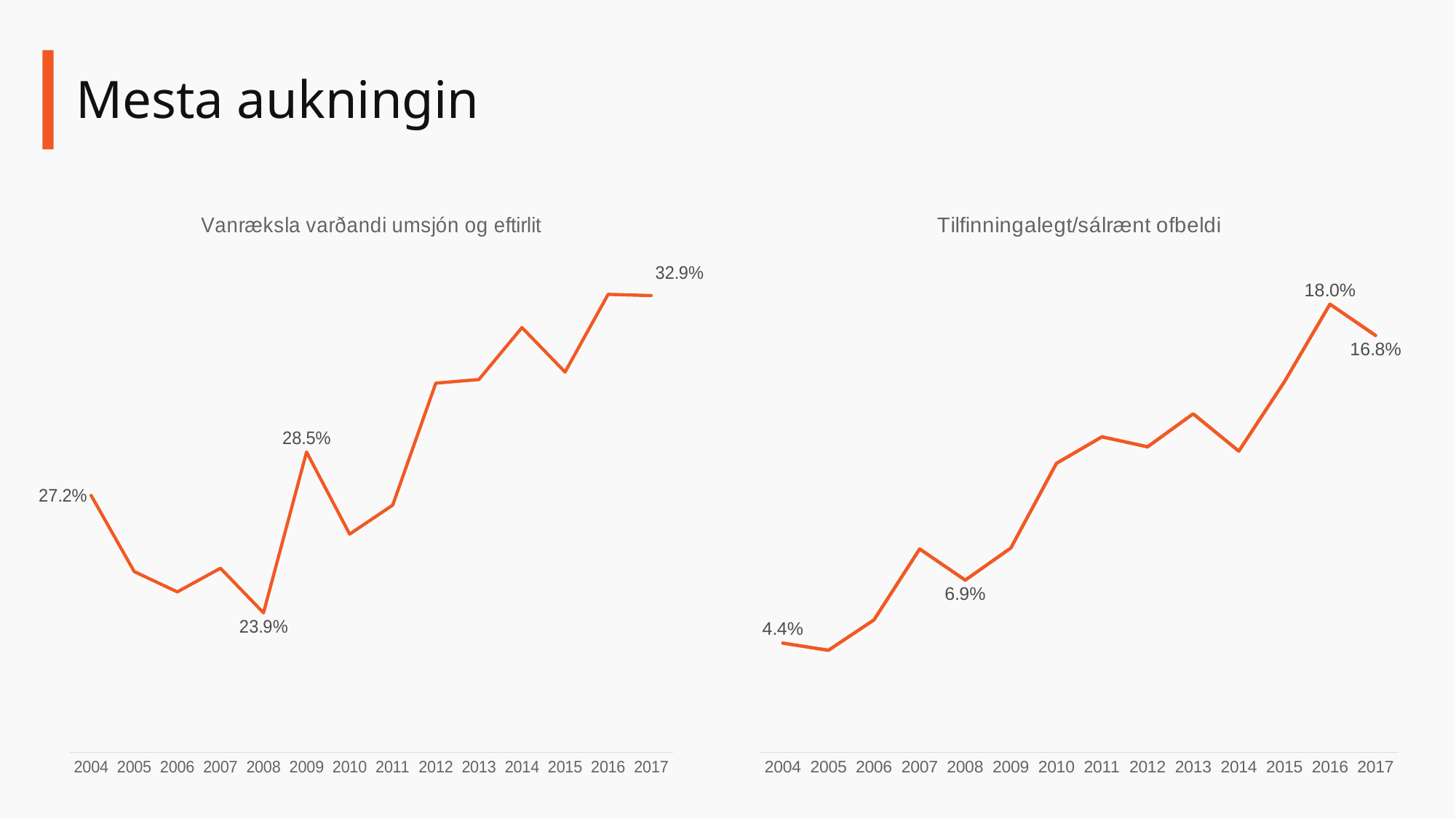
In the chart titled "Vanræksla varðandi umsjón og eftirlit", what is the difference between the 2017 value and the 2004 value? 5.7 percentage points In the chart titled "Tilfinningalegt/sálrænt ofbeldi", what is the difference between the 2016 value and the 2017 value? 1.2 percentage points In the chart titled "Vanræksla varðandi umsjón og eftirlit", which year has the lowest value? 2008 In the chart titled "Tilfinningalegt/sálrænt ofbeldi", what is the value for 2016? 18.0% In the chart titled "Vanræksla varðandi umsjón og eftirlit", which is larger, the value for 2009 or the value for 2004? 2009 In the chart titled "Vanræksla varðandi umsjón og eftirlit", what is the value for 2017? 32.9% In the chart titled "Tilfinningalegt/sálrænt ofbeldi", what is the value for 2004? 4.4% What kind of chart is the chart titled "Vanræksla varðandi umsjón og eftirlit"? Line chart In the chart titled "Tilfinningalegt/sálrænt ofbeldi", which year has the highest value? 2016 In the chart titled "Tilfinningalegt/sálrænt ofbeldi", do the values generally rise or fall from 2004 to 2016? Rise In the chart titled "Vanræksla varðandi umsjón og eftirlit", what is the value for 2004? 27.2% How many years are shown on the x axis of the chart titled "Tilfinningalegt/sálrænt ofbeldi"? 14